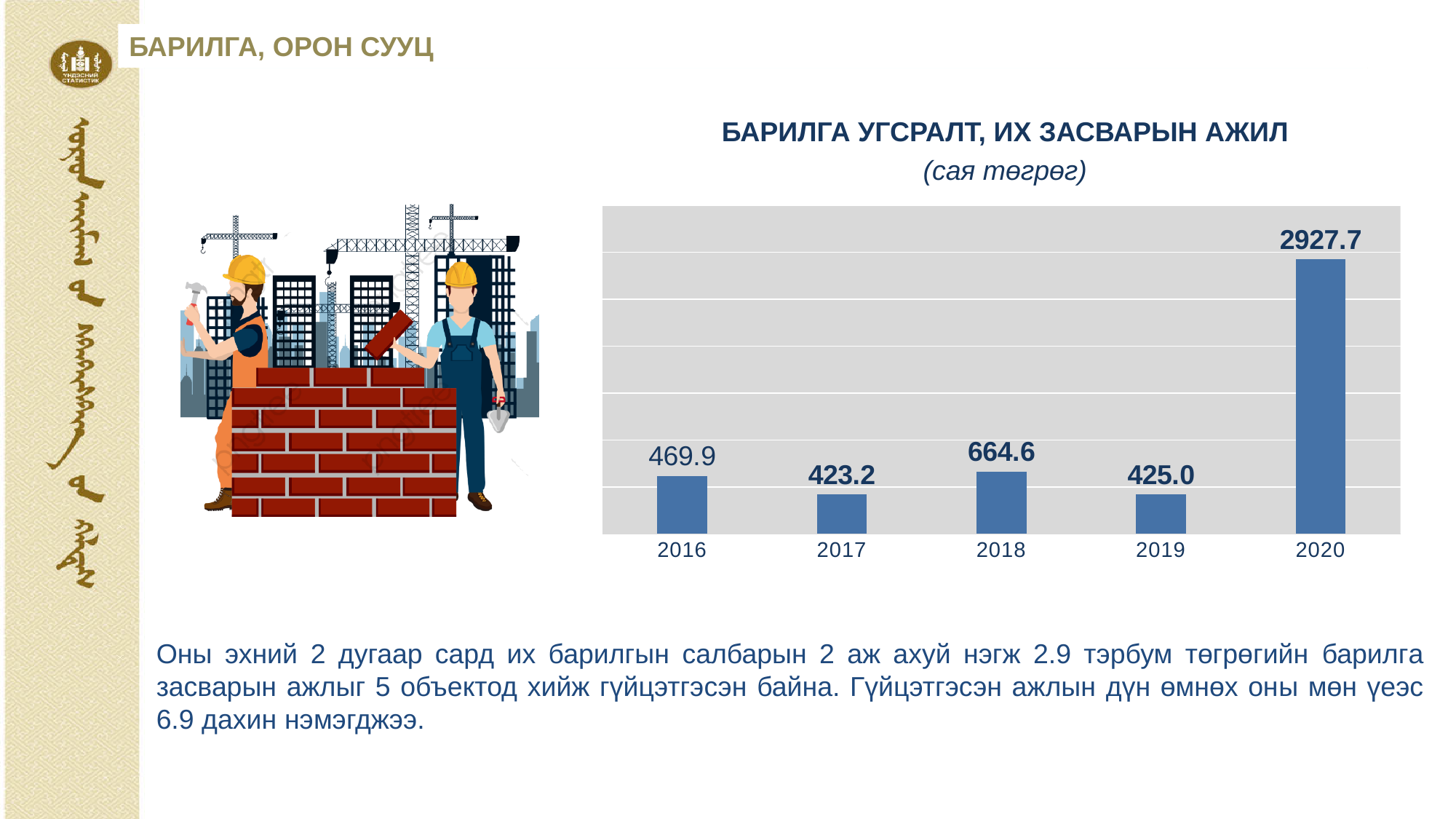
What is the value for 2016? 469.9 What is the value for 2018? 664.6 How many years are shown on the x axis? 5 Which year has the highest value? 2020 What is the value for 2019? 425.0 What type of chart is shown on the slide? bar chart What unit is given in the chart subtitle? сая төгрөг Which year has the lowest value? 2017 What is the value for 2017? 423.2 What is the value for 2020? 2927.7 What is the difference between the values for 2020 and 2019? 2502.7 Which is larger, the value for 2018 or the value for 2016? 2018